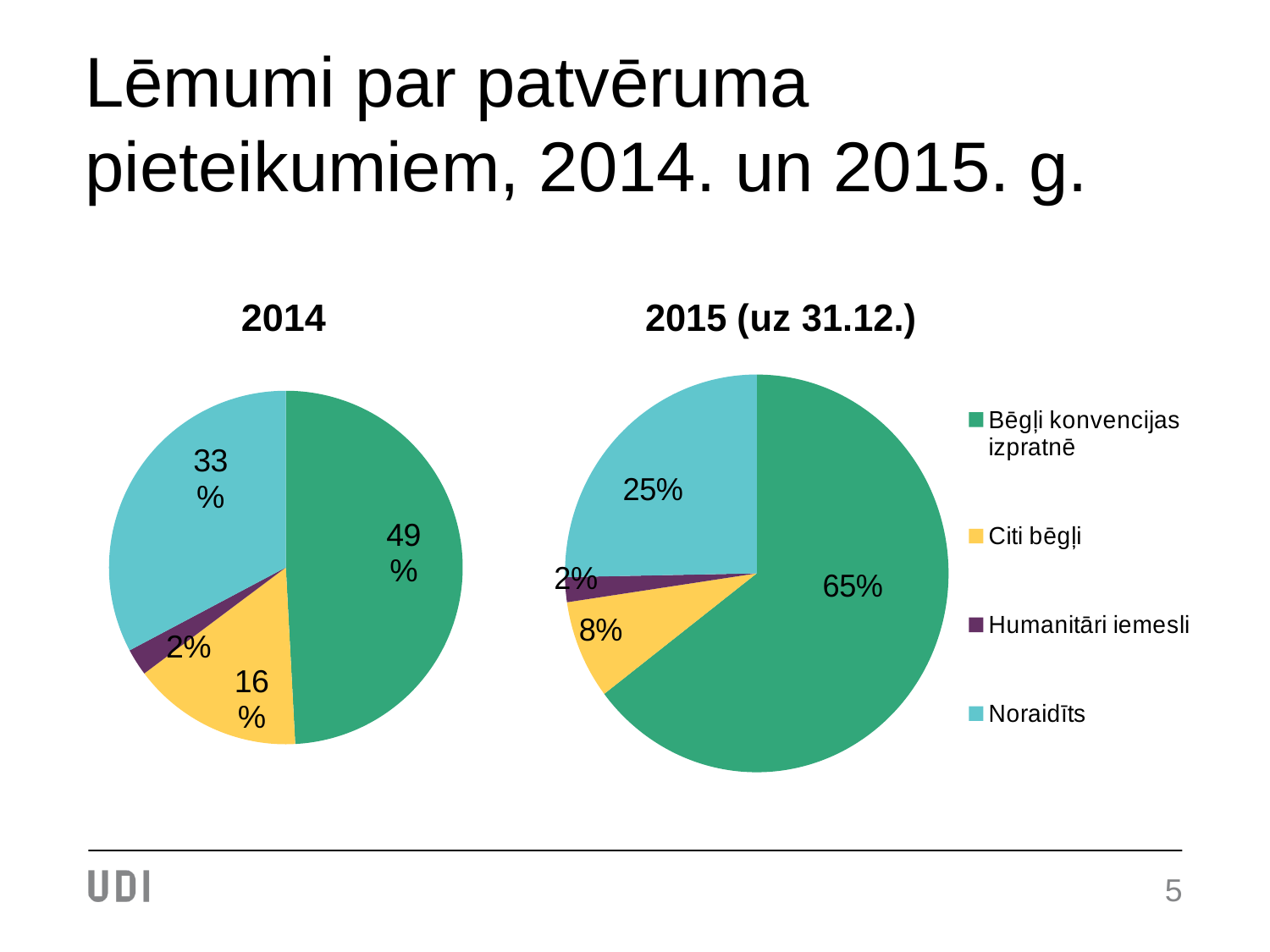
In the 2014 chart, which category has the largest slice? Bēgļi konvencijas izpratnē Which chart shows a larger share for Noraidīts, the 2014 chart or the 2015 (uz 31.12.) chart? 2014 In the 2014 chart, what share is labelled for Humanitāri iemesli? 2% In the 2014 chart, what share is labelled for Bēgļi konvencijas izpratnē? 49% Which colour represents Citi bēgļi in the legend? Yellow In the 2014 chart, what is the difference between the Noraidīts share and the Citi bēgļi share? 17 percentage points What is the difference between the Bēgļi konvencijas izpratnē share in the 2015 (uz 31.12.) chart and in the 2014 chart? 16 percentage points How many slices does the 2015 (uz 31.12.) pie chart have? 4 In the 2015 (uz 31.12.) chart, what share is labelled for Noraidīts? 25% What type of chart is used for the 2014 data? Pie chart In the 2015 (uz 31.12.) chart, what share is labelled for Citi bēgļi? 8% In the 2015 (uz 31.12.) chart, which category has the smallest slice? Humanitāri iemesli